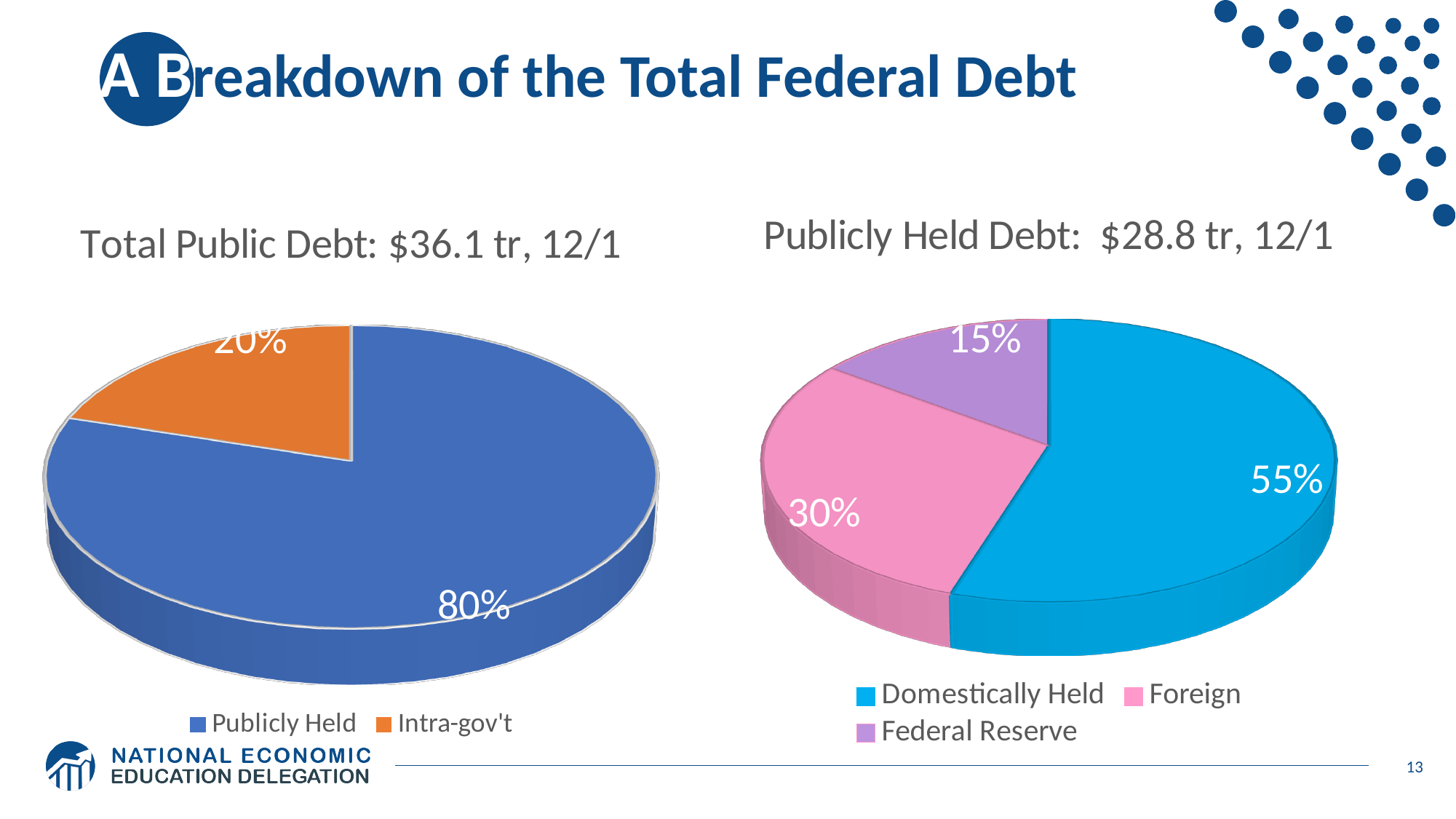
In the Total Public Debt pie chart on the left, what share is Publicly Held? 80% What total value is given in the title of the chart on the right? $28.8 tr In the Publicly Held Debt pie chart on the right, which category has the largest share? Domestically Held In the Publicly Held Debt pie chart on the right, which category has the smallest share? Federal Reserve In the Publicly Held Debt pie chart on the right, what share is Federal Reserve? 15% How many categories does the legend of the Publicly Held Debt pie chart on the right list? 3 In the Total Public Debt pie chart on the left, which is larger, Publicly Held or Intra-gov't? Publicly Held In the Publicly Held Debt pie chart on the right, what share is Foreign? 30% In the Publicly Held Debt pie chart on the right, what share is Domestically Held? 55% What kind of chart is the chart on the left of the slide? Pie chart In the Publicly Held Debt pie chart on the right, what is the difference in percentage points between the Foreign and Federal Reserve shares? 15 In the Total Public Debt pie chart on the left, what share is Intra-gov't? 20%